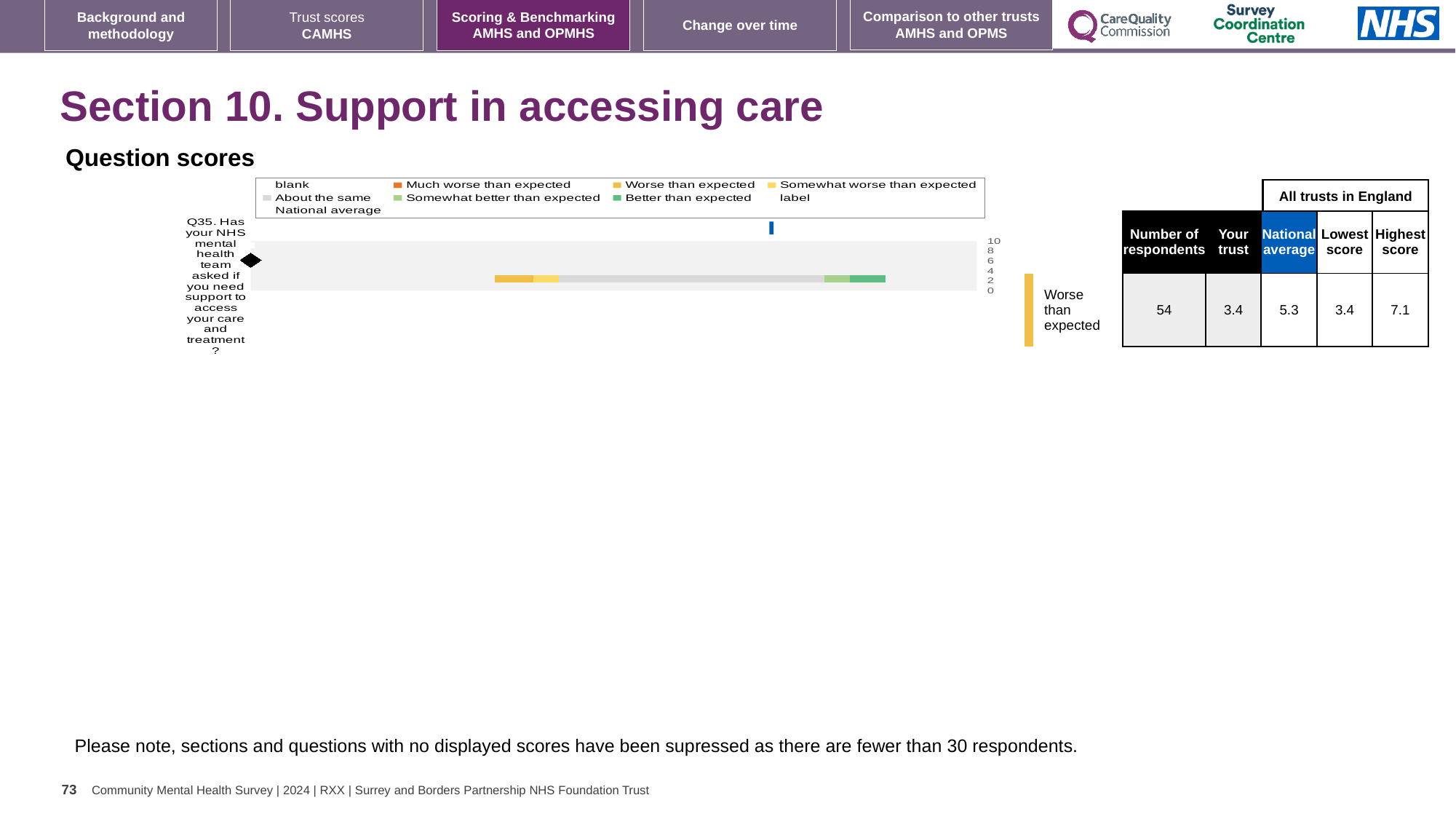
By how much does the national average exceed the 'Your trust' score for Q35? 1.9 What benchmark rating label is shown next to the Q35 bar? Worse than expected How many questions (categories) are plotted in the Question scores chart? 1 What is the national average score for Q35? 5.3 What is the 'Your trust' score for Q35? 3.4 Which question is plotted in the Question scores chart? Q35. Has your NHS mental health team asked if you need support to access your care and treatment? Which is larger for Q35, the 'Your trust' score or the national average? National average What is the difference between the highest and lowest trust scores for Q35? 3.7 What is the number of respondents for Q35? 54 What is the highest score among all trusts in England for Q35? 7.1 What kind of chart is used to show the Q35 question score? bar chart What is the lowest score among all trusts in England for Q35? 3.4